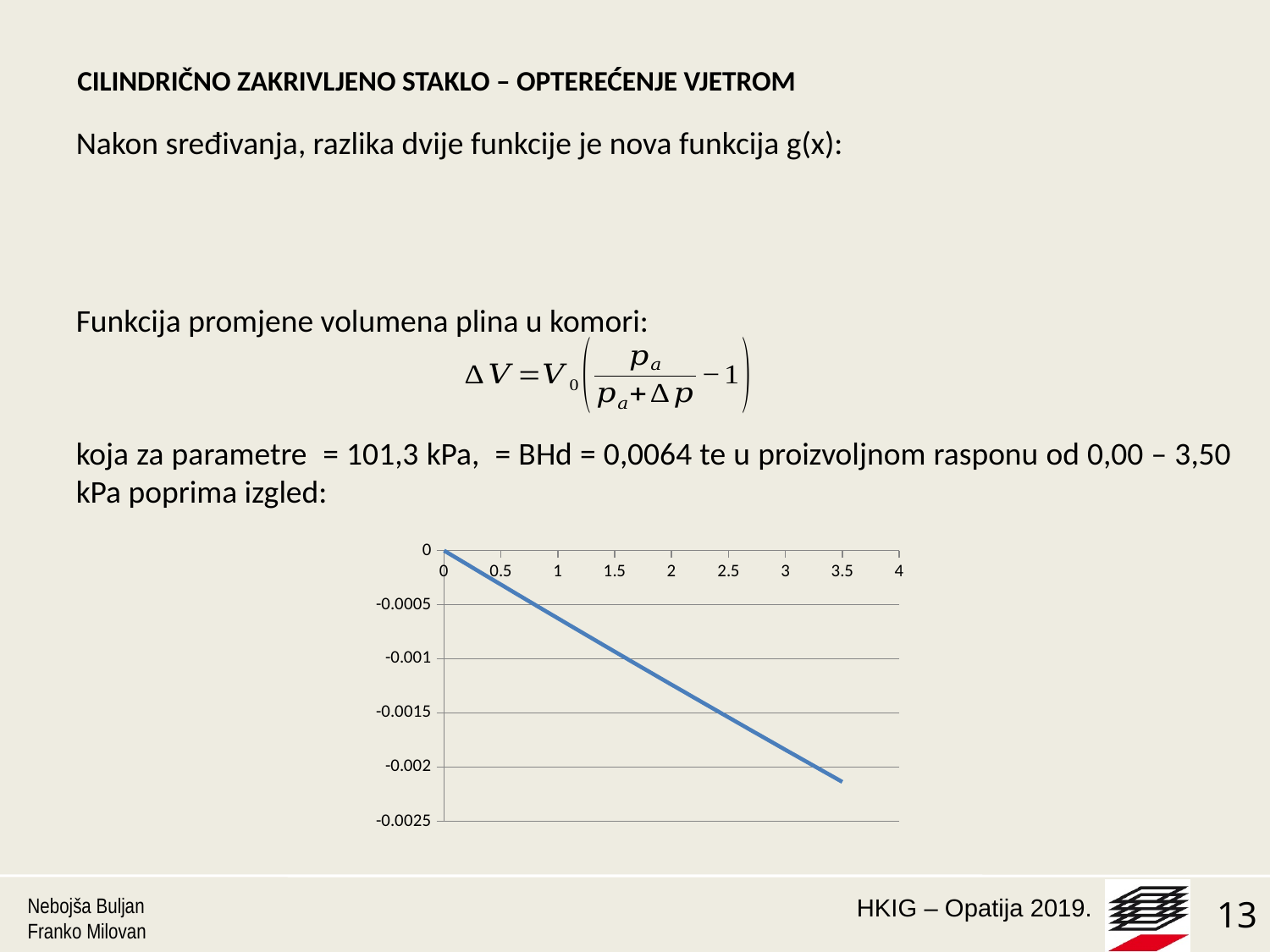
Is the plotted value at x = 3 greater or less than -0.0015? less Is the plotted value at x = 2 greater or less than -0.001? less Is the plotted value at x = 1 greater or less than -0.0005? less What is the lowest tick label shown on the vertical axis? -0.0025 At which x value does the line reach its highest plotted value? 0 Do the plotted values rise or fall as x increases from 0 to 3.5? fall Which of the two x values, 1 or 3, has the larger plotted value? 1 What kind of chart is shown on the slide? line chart What is the plotted value at x = 0? 0 How many lines (series) are plotted on the chart? 1